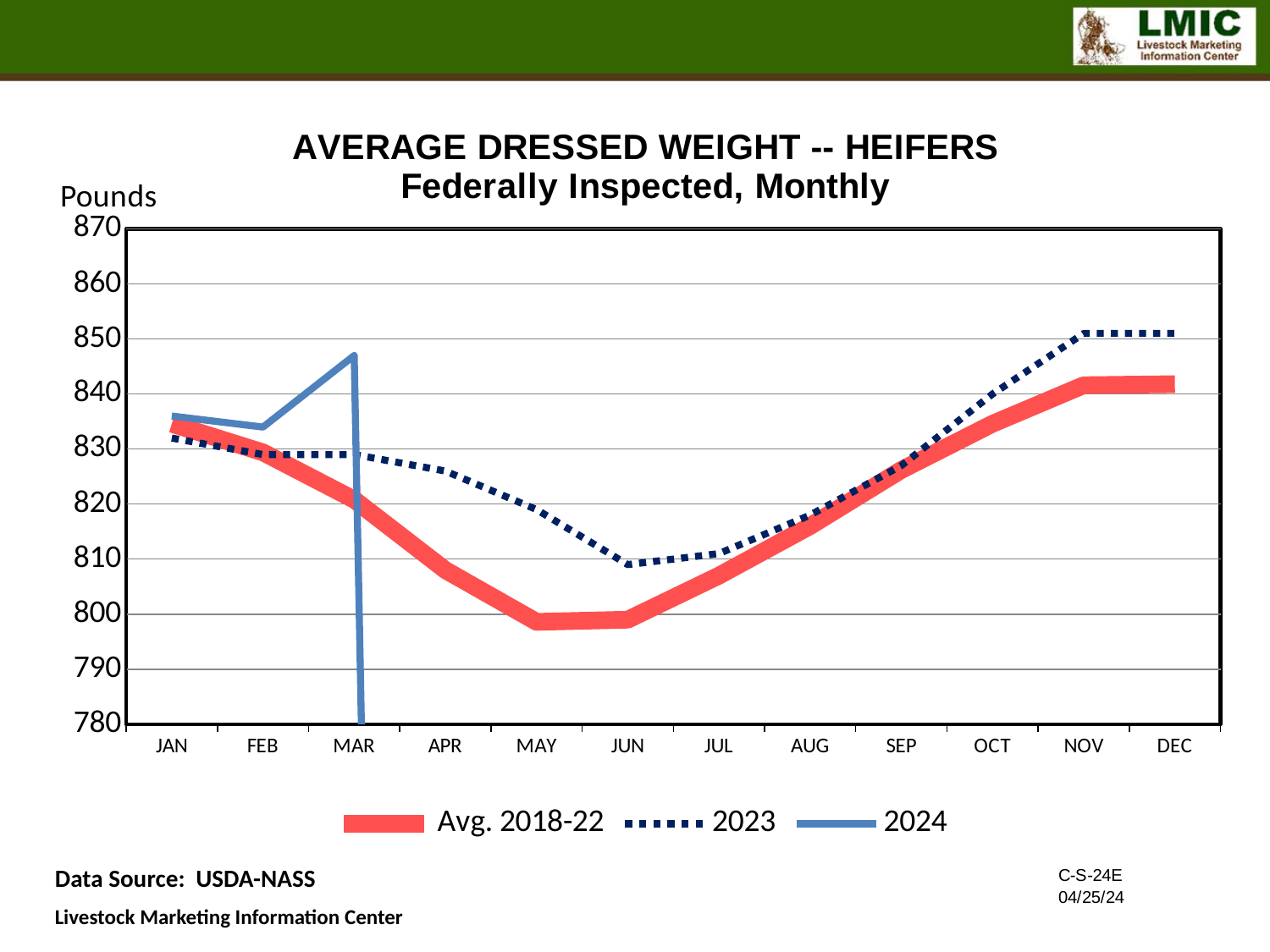
In JUN, which series has the larger value, 2023 or Avg. 2018-22? 2023 Is the 2024 value for MAR greater or less than 840? greater Does the 2023 series rise or fall from JUN to NOV? rise Is the Avg. 2018-22 value for MAY greater or less than 810? less What kind of chart is shown on the slide? line chart How many months are shown along the x axis? 12 Does the Avg. 2018-22 series rise or fall from JAN to MAY? fall In MAR, which series has the larger value, 2024 or 2023? 2024 What unit is shown on the y axis label? Pounds Is the 2023 value for JUN greater or less than 820? less How many series does the legend list? 3